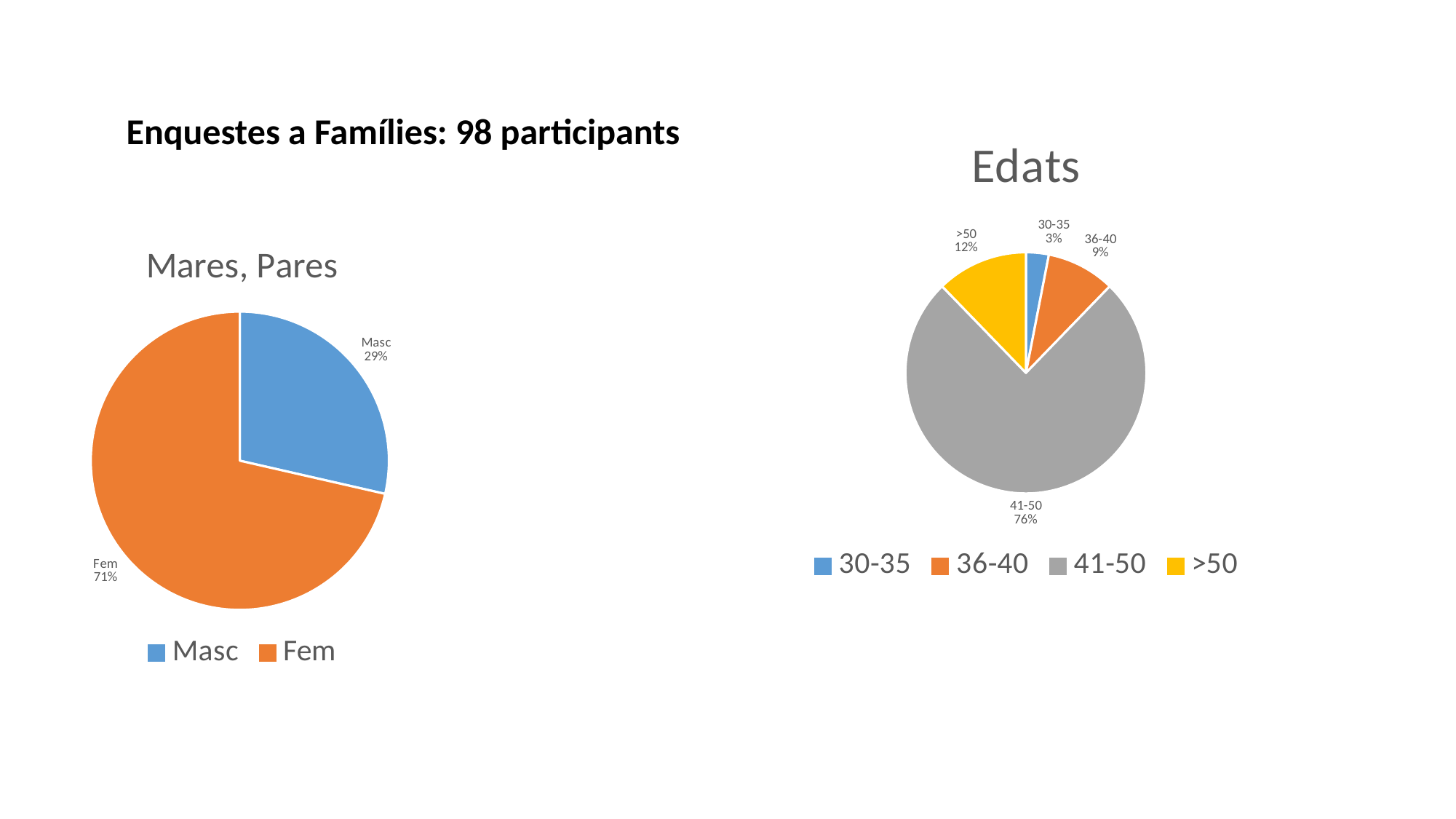
In the 'Edats' chart, what share does the 41-50 group have? 76% In the 'Mares, Pares' chart, what share does Fem have? 71% In the 'Edats' chart, which colour represents the 41-50 group? Grey In the 'Edats' chart, what is the difference in percentage points between the >50 group and the 36-40 group? 3 What kind of chart is the 'Mares, Pares' chart? Pie chart In the 'Edats' chart, which age group has the smallest share? 30-35 In the 'Edats' chart, what share does the >50 group have? 12% In the 'Mares, Pares' chart, what share does Masc have? 29% In the 'Edats' chart, how many age groups are shown? 4 In the 'Edats' chart, which age group has the largest share? 41-50 In the 'Mares, Pares' chart, what is the difference in percentage points between Fem and Masc? 42 In the 'Mares, Pares' chart, which slice is larger, Masc or Fem? Fem